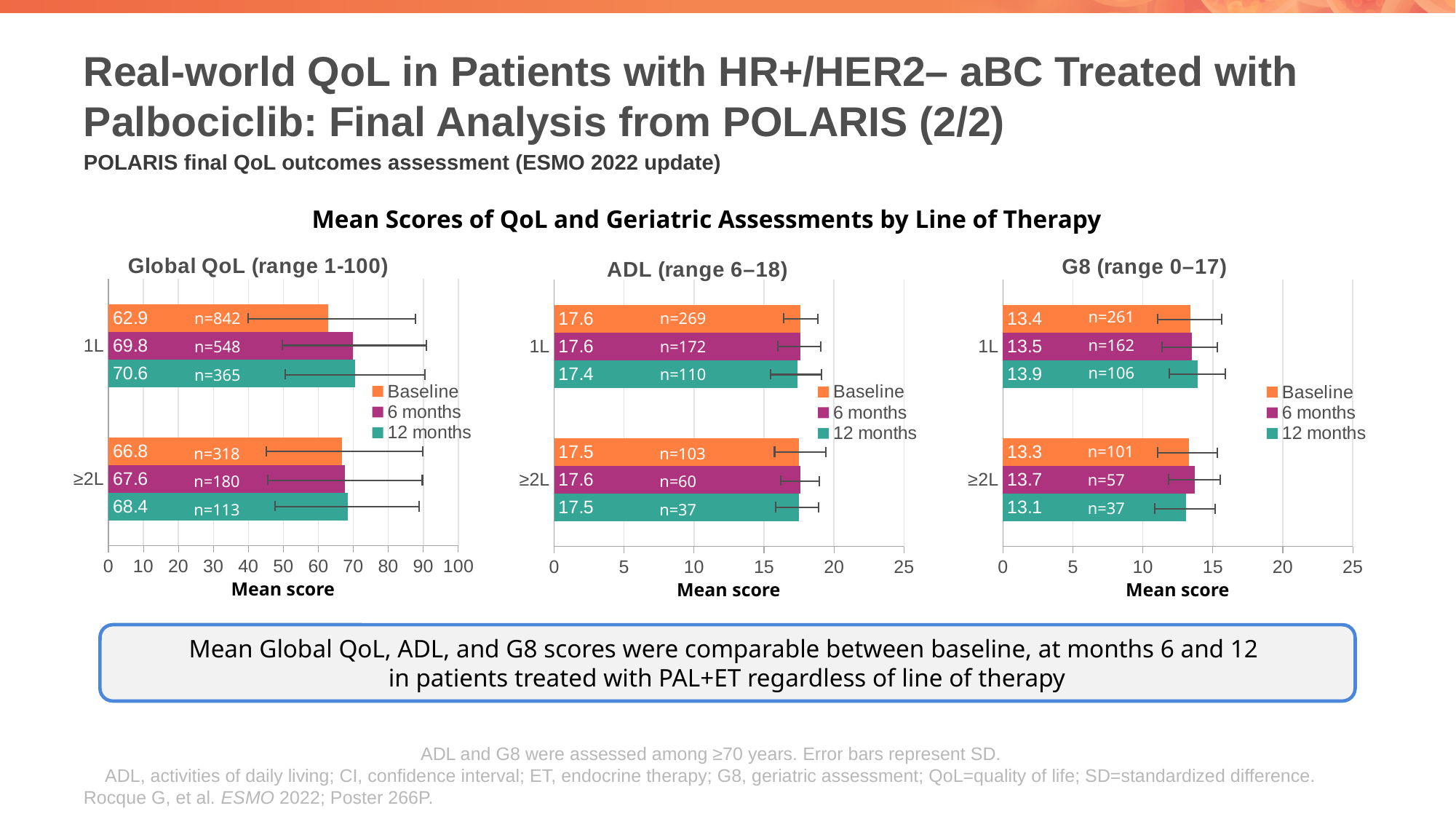
In the Global QoL (range 1-100) chart, what is the mean score for the Baseline series in the 1L group? 62.9 In the ADL (range 6–18) chart, what is the mean score for the 12 months series in the 1L group? 17.4 In the G8 (range 0–17) chart, which is larger: the 12 months mean score for 1L or the 12 months mean score for ≥2L? 1L In the G8 (range 0–17) chart, what is the mean score for the 6 months series in the ≥2L group? 13.7 In the Global QoL (range 1-100) chart, is the Baseline mean score for ≥2L greater or less than 60? greater How many series does the legend of the ADL (range 6–18) chart list? 3 What kind of chart is the G8 (range 0–17) chart? Bar chart In the Global QoL (range 1-100) chart, what is the difference between the 12 months and Baseline mean scores in the 1L group? 7.7 In the G8 (range 0–17) chart, which series has the lowest mean score in the ≥2L group? 12 months In the Global QoL (range 1-100) chart, what is the mean score for the 12 months series in the ≥2L group? 68.4 In the Global QoL (range 1-100) chart, which series has the highest mean score in the 1L group? 12 months In the ADL (range 6–18) chart, what is the n value shown for the 6 months series in the ≥2L group? n=60